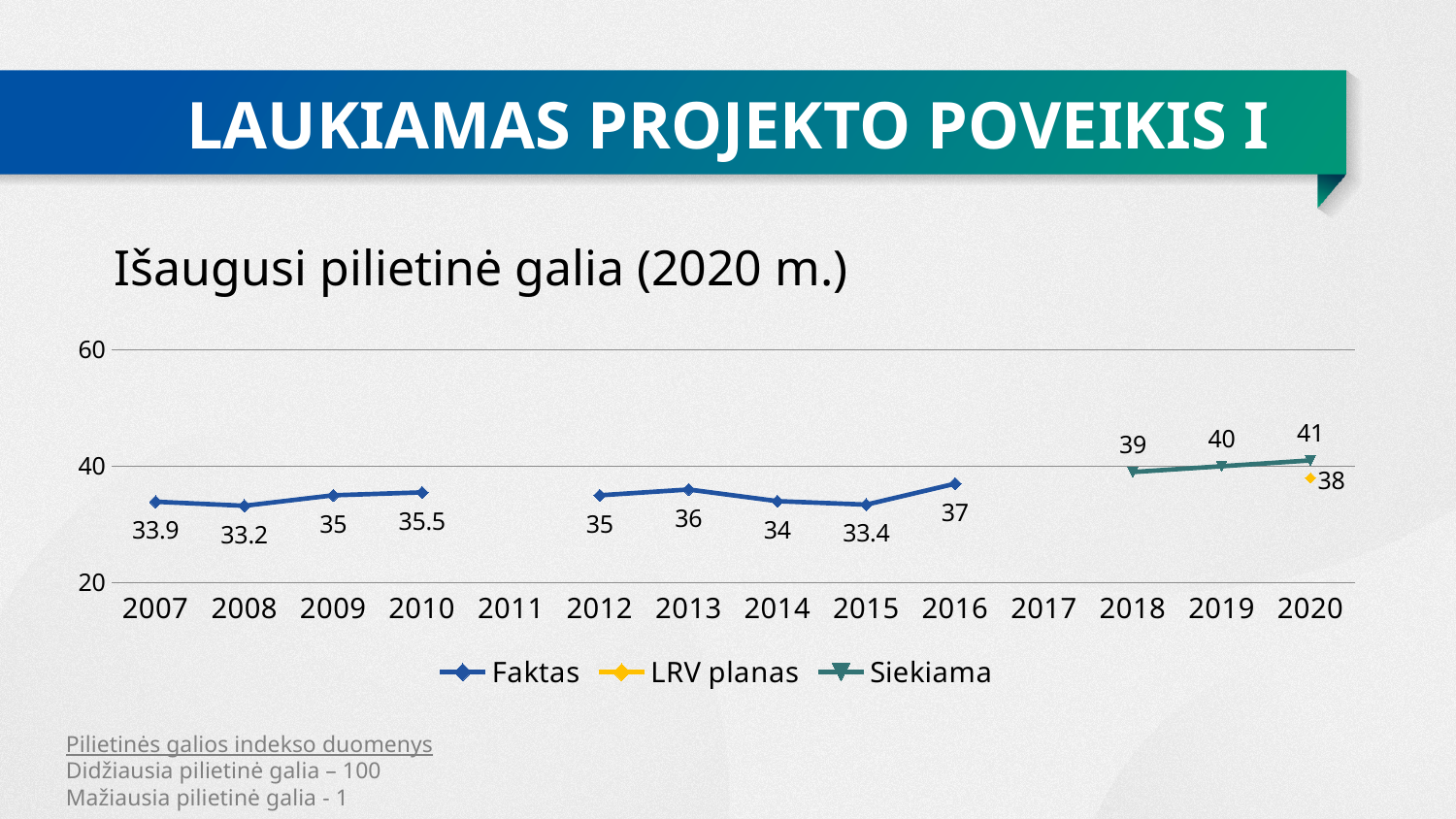
Which is larger, the Faktas value for 2010 or for 2014? 2010 In which year is the Faktas series lowest? 2008 What is the Faktas value for 2016? 37 What is the Faktas value for 2008? 33.2 How many series does the legend list? 3 What is the difference between the Faktas values for 2016 and 2015? 3.6 In which year is the Faktas series highest? 2016 What kind of chart is shown on the slide? line chart What is the Siekiama value for 2020? 41 What is the difference between the Siekiama value and the LRV planas value for 2020? 3 What is the LRV planas value for 2020? 38 Is the Siekiama value for 2018 greater or less than 40? less